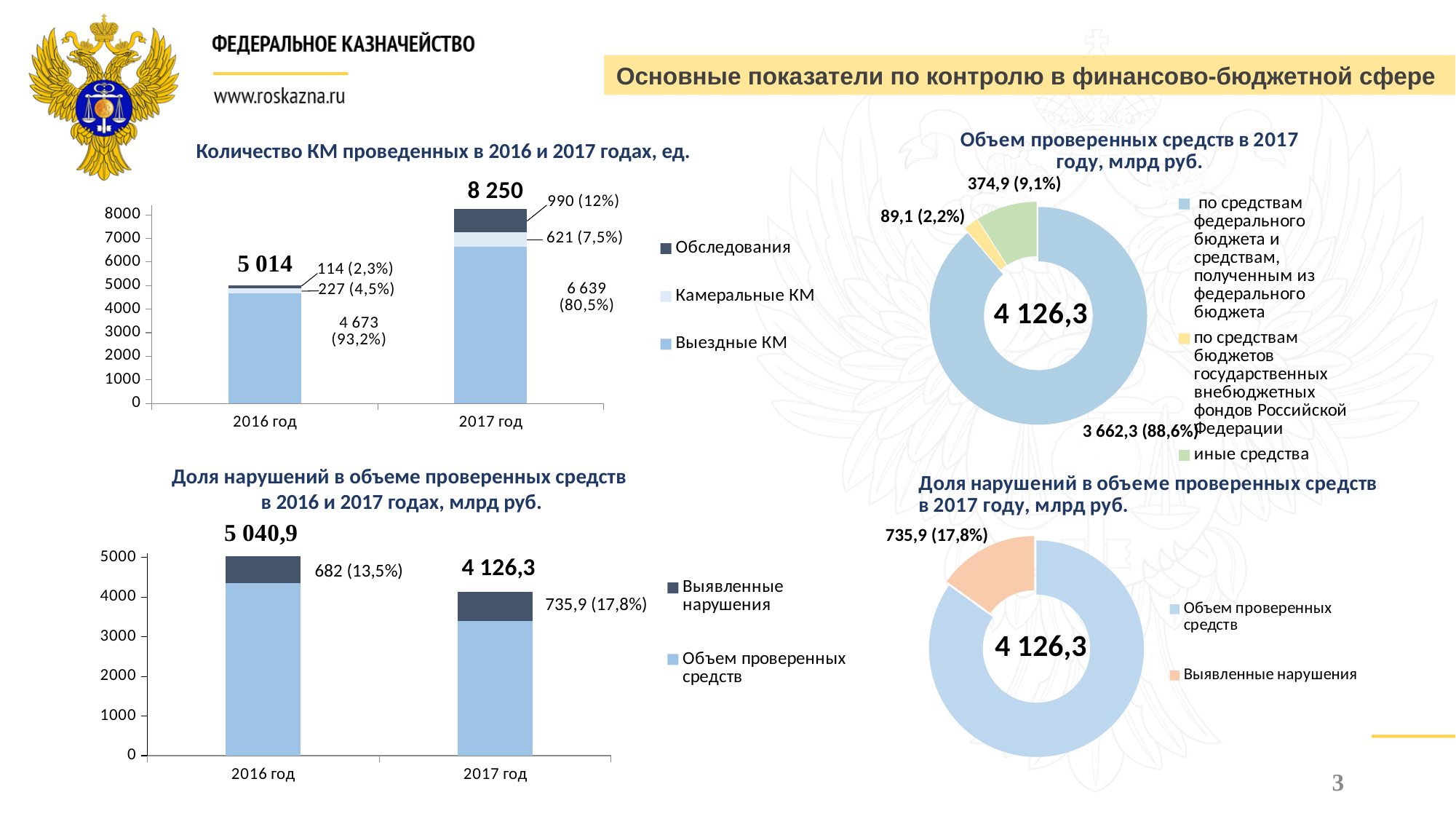
In the chart 'Объем проверенных средств в 2017 году, млрд руб.', what is the value for funds of the federal budget (по средствам федерального бюджета)? 3 662,3 In the chart 'Количество КМ проведенных в 2016 и 2017 годах, ед.', what is the value for Выездные КМ in 2016 год? 4 673 How many series does the legend of the chart 'Количество КМ проведенных в 2016 и 2017 годах, ед.' list? 3 In the chart 'Доля нарушений в объеме проверенных средств в 2017 году, млрд руб.', what share of the total do Выявленные нарушения make up? 17,8% In the chart 'Количество КМ проведенных в 2016 и 2017 годах, ед.', what is the total number of КМ for 2017 год? 8 250 In the chart 'Доля нарушений в объеме проверенных средств в 2016 и 2017 годах, млрд руб.', what is the value of Выявленные нарушения for 2016 год? 682 In the chart 'Количество КМ проведенных в 2016 и 2017 годах, ед.', by how much did the total number of КМ increase from 2016 год to 2017 год? 3 236 In the chart 'Объем проверенных средств в 2017 году, млрд руб.', what share of the total is 'иные средства'? 9,1% What kind of chart is 'Объем проверенных средств в 2017 году, млрд руб.'? Doughnut (pie) chart In the chart 'Объем проверенных средств в 2017 году, млрд руб.', which category has the smallest value? по средствам бюджетов государственных внебюджетных фондов Российской Федерации In the chart 'Доля нарушений в объеме проверенных средств в 2016 и 2017 годах, млрд руб.', which year has the larger total bar, 2016 год or 2017 год? 2016 год In the chart 'Количество КМ проведенных в 2016 и 2017 годах, ед.', what is the value for Обследования in 2017 год? 990